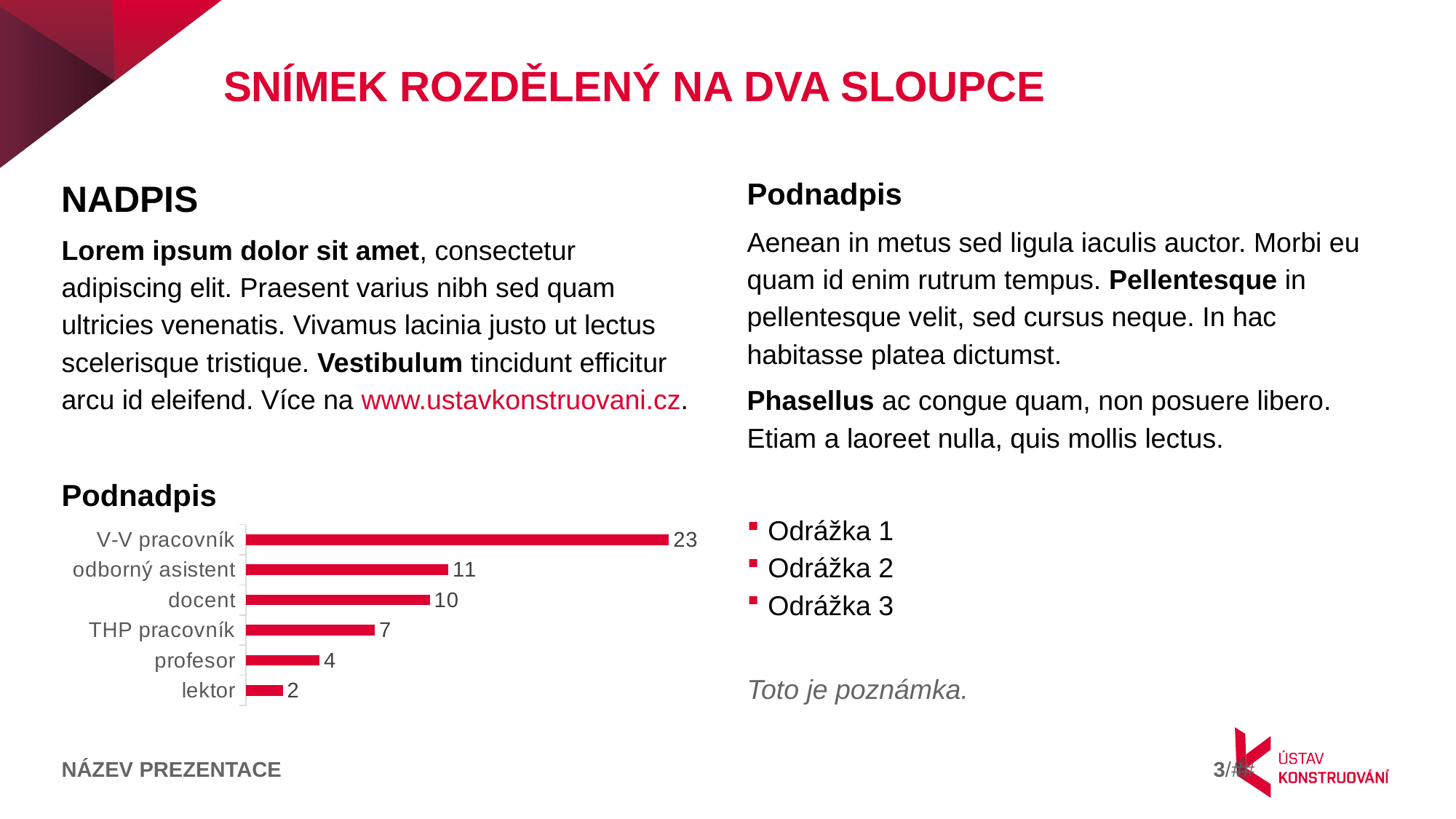
What is the difference between the values for V-V pracovník and docent? 13 Which category has the lowest value? lektor What kind of chart is shown on the slide? bar chart Which category has the highest value? V-V pracovník How many categories does the chart show? 6 Which is larger, the value for THP pracovník or the value for profesor? THP pracovník What is the value for docent? 10 What is the value for lektor? 2 What is the value for THP pracovník? 7 What colour are the bars in the chart? red What is the value for V-V pracovník? 23 What is the difference between the values for odborný asistent and profesor? 7